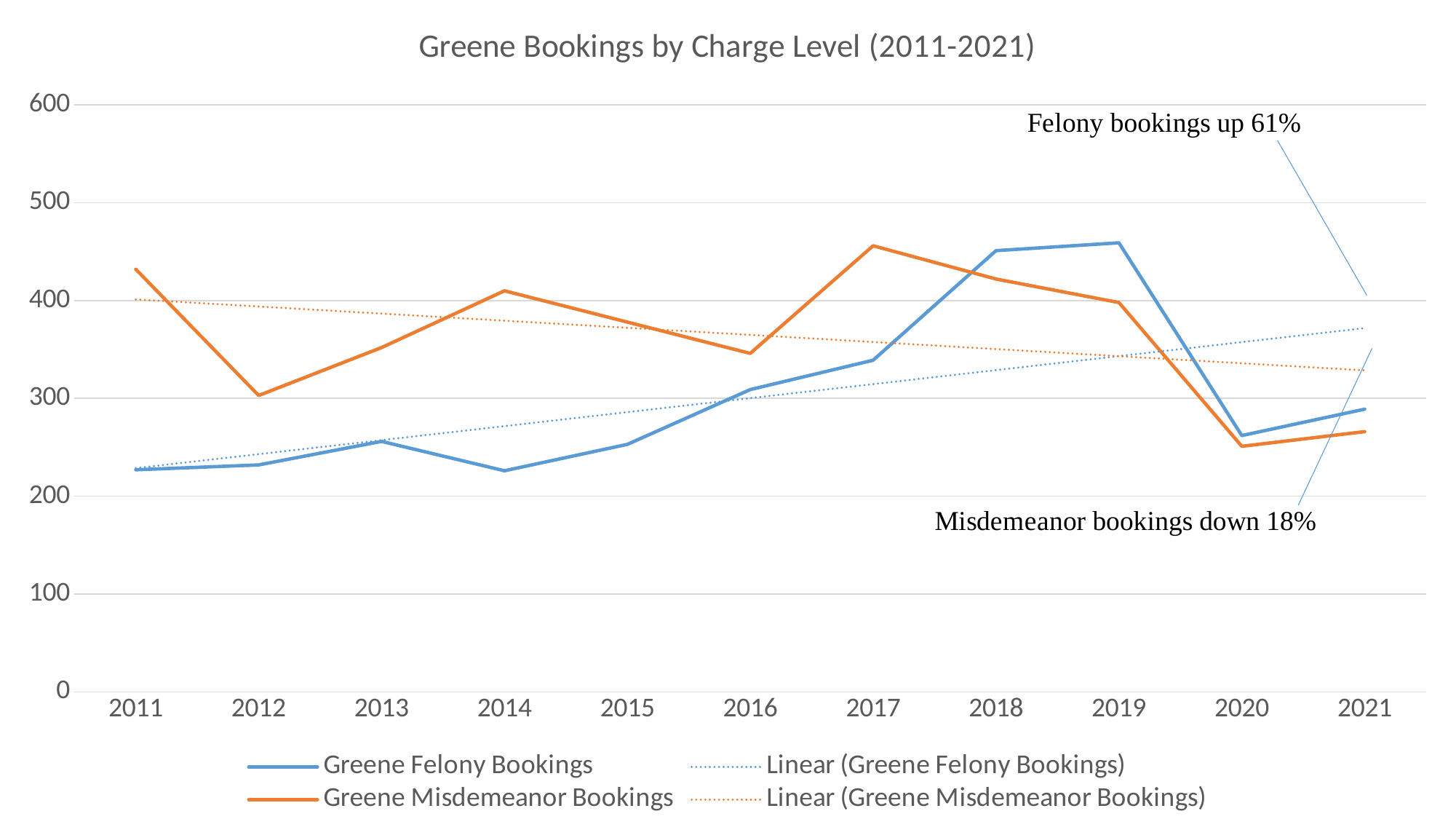
How many series does the legend list? 4 In 2011, which is larger: Greene Felony Bookings or Greene Misdemeanor Bookings? Greene Misdemeanor Bookings In 2018, which is larger: Greene Felony Bookings or Greene Misdemeanor Bookings? Greene Felony Bookings According to the annotation on the chart, by what percentage did felony bookings go up? 61% In which year are Greene Misdemeanor Bookings highest? 2017 In which year are Greene Misdemeanor Bookings lowest? 2020 How many years are shown on the x axis? 11 Is the value for Greene Misdemeanor Bookings in 2011 greater or less than 400? greater Is the value for Greene Felony Bookings in 2014 greater or less than 300? less What is the title of the chart? Greene Bookings by Charge Level (2011-2021) What kind of chart is shown on the slide? line chart Is the value for Greene Felony Bookings in 2019 greater or less than 400? greater